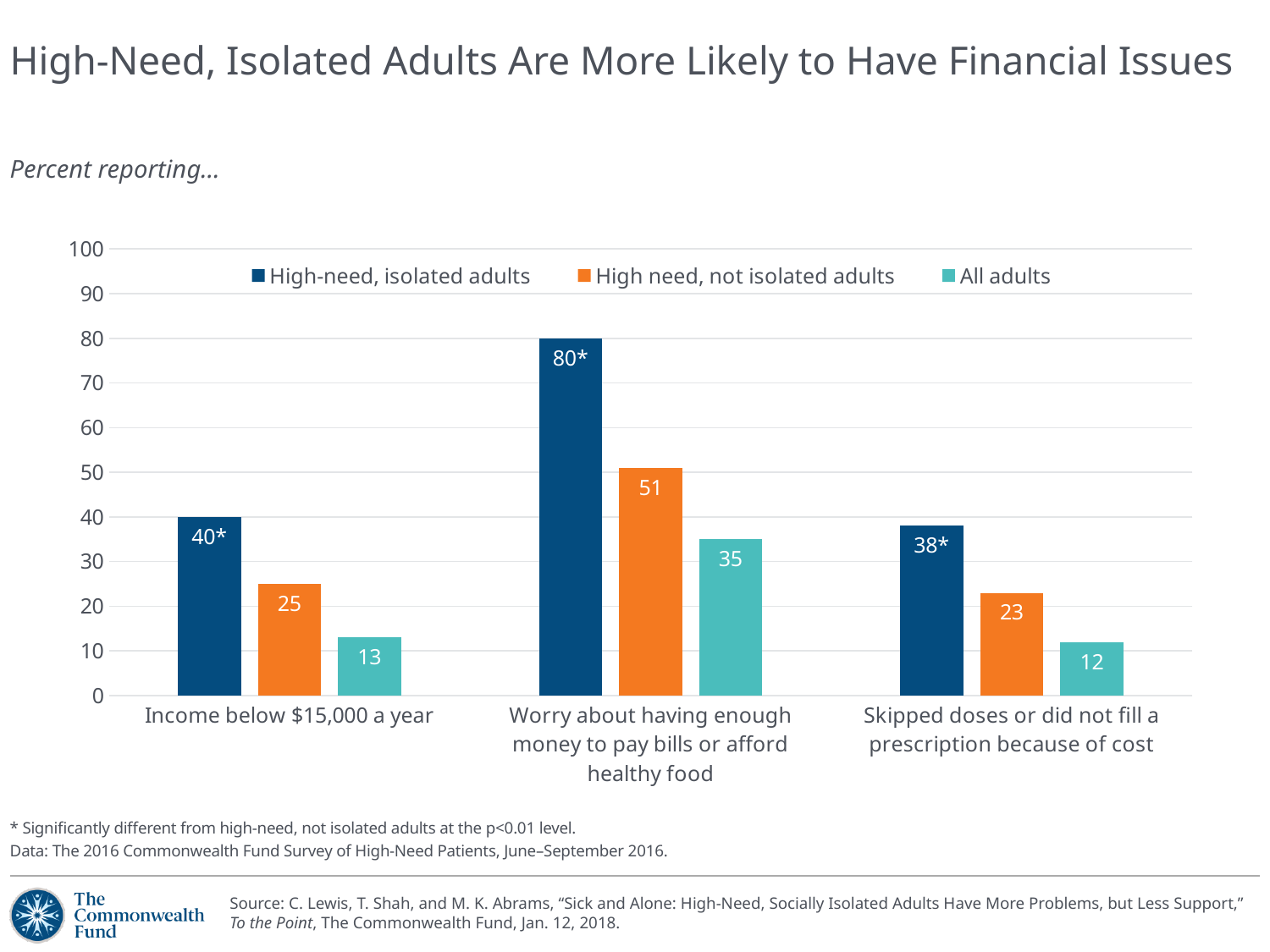
What is the value for All adults in the 'Worry about having enough money to pay bills or afford healthy food' category? 35 Which category has the highest value for High-need, isolated adults? Worry about having enough money to pay bills or afford healthy food Which series is shown in orange in the legend? High need, not isolated adults What is the value for High need, not isolated adults in the 'Skipped doses or did not fill a prescription because of cost' category? 23 How many series does the legend list? 3 What is the value for High-need, isolated adults in the 'Income below $15,000 a year' category? 40* How many categories are shown on the x axis? 3 What is the difference between High-need, isolated adults and All adults in the 'Skipped doses or did not fill a prescription because of cost' category? 26 Which is larger in the 'Income below $15,000 a year' category: High need, not isolated adults or All adults? High need, not isolated adults Which category has the lowest value for All adults? Skipped doses or did not fill a prescription because of cost What is the difference between High-need, isolated adults and High need, not isolated adults in the 'Worry about having enough money to pay bills or afford healthy food' category? 29 What kind of chart is shown on the slide? Bar chart